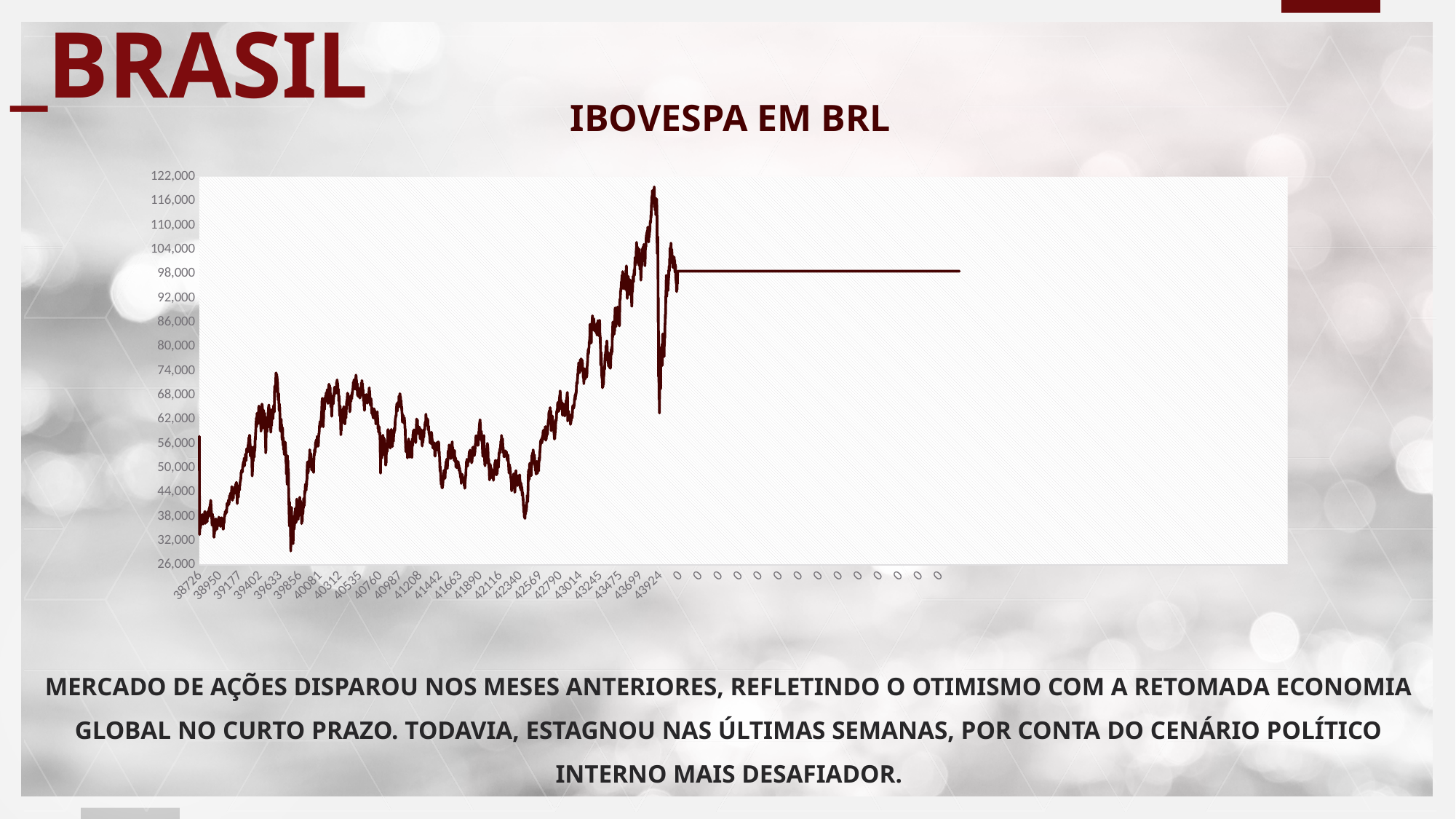
Is the value of the flat section at the right end of the line greater or less than 92,000? greater Is the lowest point of the line greater or less than 32,000? less Is the value of the flat section at the right end of the line greater or less than 104,000? less What is the highest value shown on the chart's vertical axis? 122,000 What is the title of the chart? IBOVESPA EM BRL What kind of chart is shown on the slide? line chart Overall, does the line rise or fall from the left of the chart to its peak near the right? rise